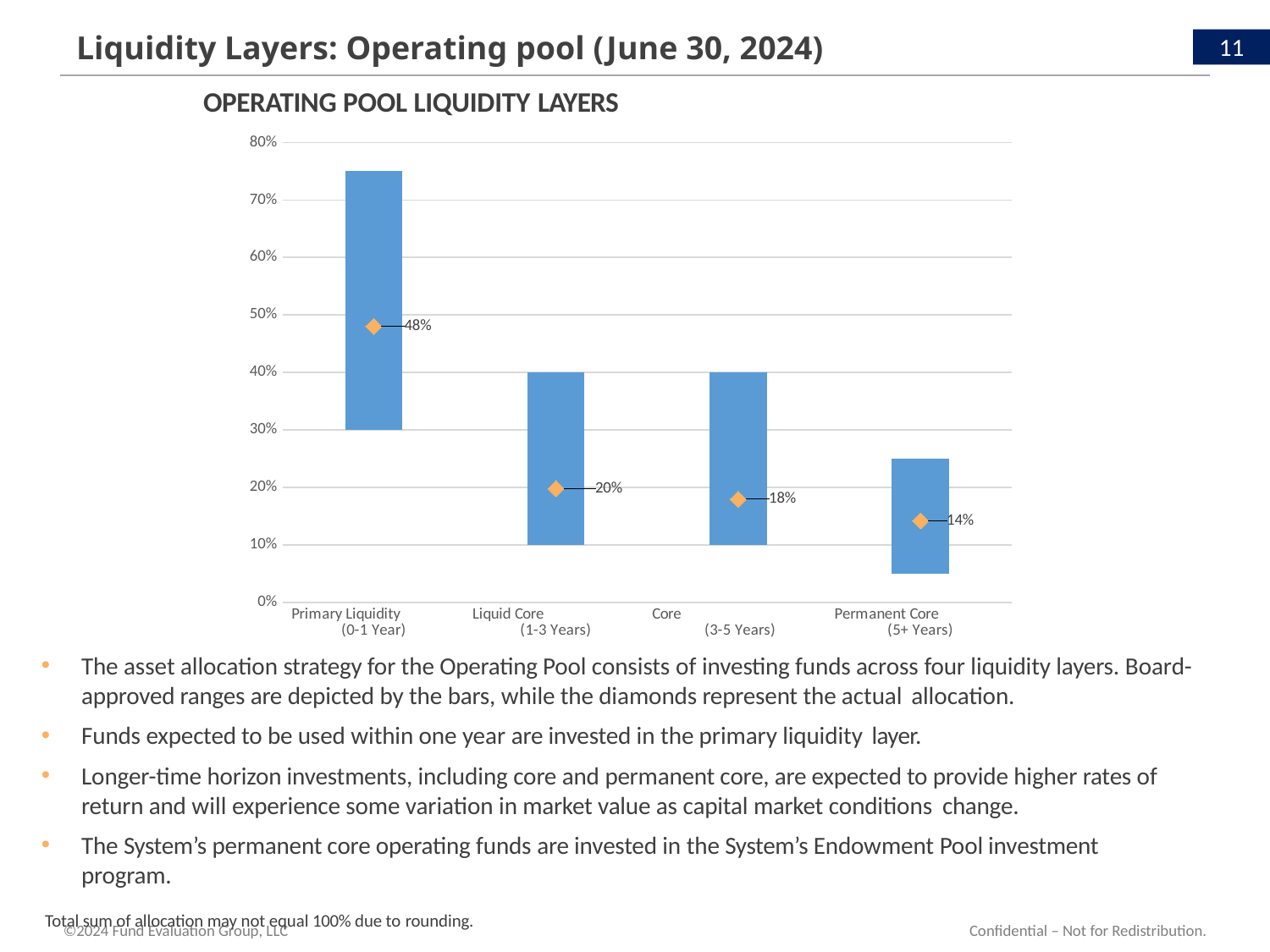
What is the difference between the actual allocation for Primary Liquidity and the actual allocation for Liquid Core? 28% What is the actual allocation shown for Permanent Core (5+ Years)? 14% What is the title of the chart? OPERATING POOL LIQUIDITY LAYERS Which has a larger actual allocation, Core (3-5 Years) or Permanent Core (5+ Years)? Core (3-5 Years) What is the actual allocation shown for Liquid Core (1-3 Years)? 20% What is the actual allocation shown for Primary Liquidity (0-1 Year)? 48% What is the actual allocation shown for Core (3-5 Years)? 18% Is the top of the Board-approved range bar for Primary Liquidity greater or less than 70%? greater Which liquidity layer has the lowest actual allocation? Permanent Core (5+ Years) Do the actual allocation values (diamonds) rise or fall moving from left to right across the x axis? fall How many liquidity layers are shown on the x axis of the chart? 4 Which liquidity layer has the highest actual allocation? Primary Liquidity (0-1 Year)